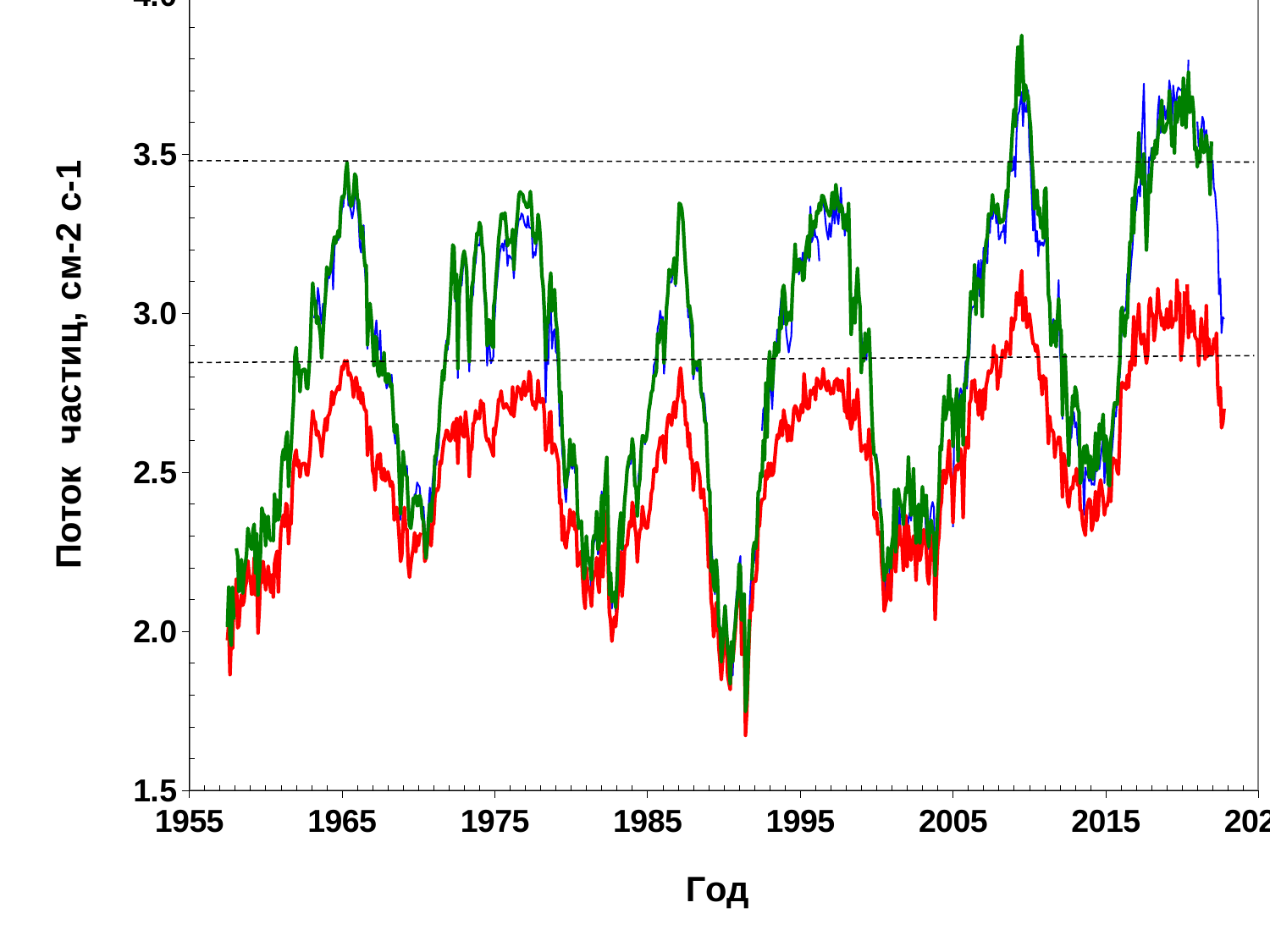
Is the value of the red line around 2017 greater or less than 2.5? greater Is the value of the red line at its peak around 1965 greater or less than 3.0? less Is the value of the green line at its peak around 1987 greater or less than 3.0? greater Around which year do the lines reach their lowest value: 1991 or 2009? 1991 What kind of chart is shown on the slide? line chart Which line is lower around 2017, the red line or the green line? the red line What is the label of the vertical axis? Поток частиц, см-2 с-1 What is the label of the horizontal axis? Год